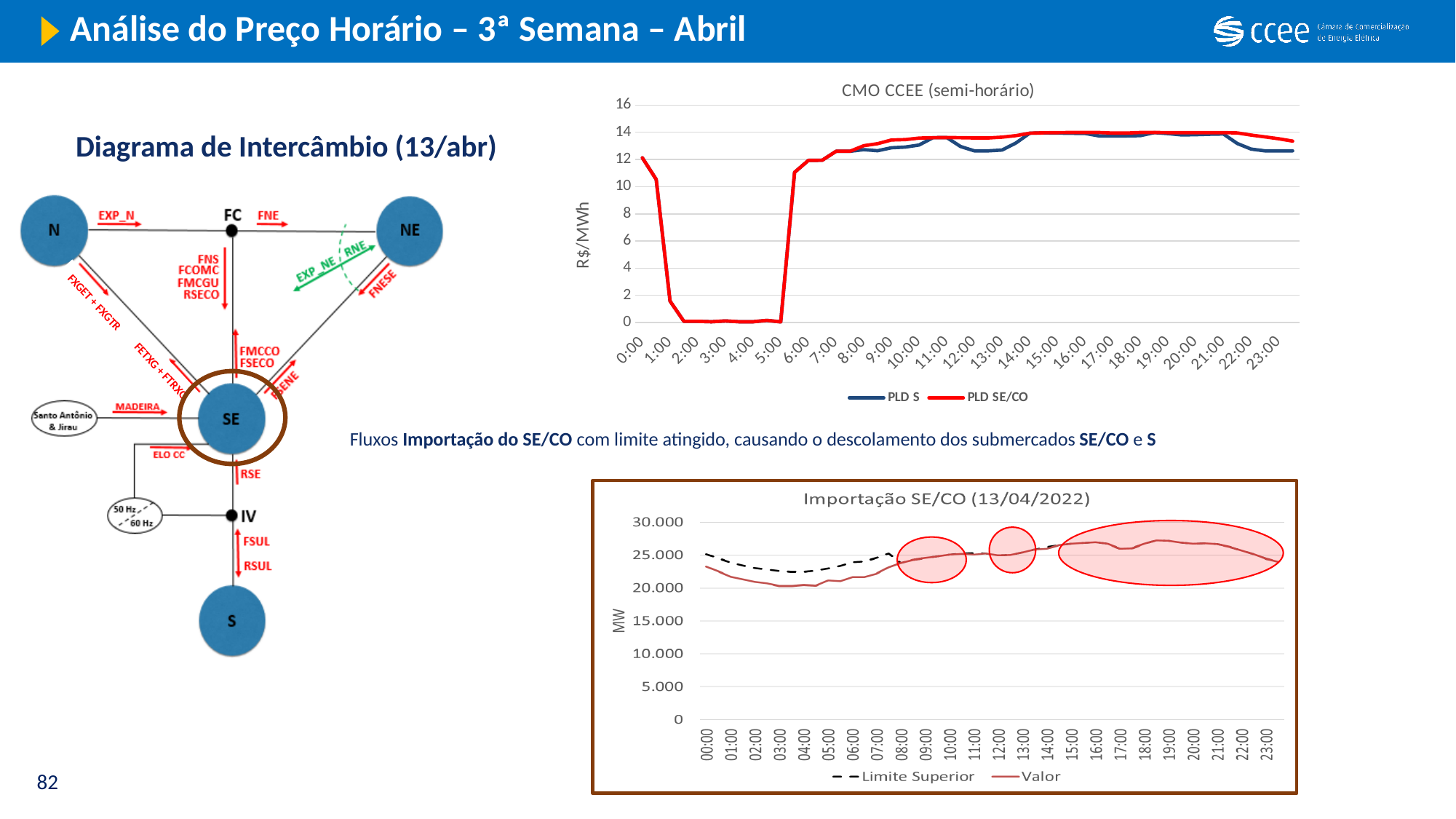
In the 'Importação SE/CO (13/04/2022)' chart, is the value of Valor at 19:00 greater or less than 25.000? greater How many series does the legend of the 'CMO CCEE (semi-horário)' chart list? 2 What kind of chart is the 'CMO CCEE (semi-horário)' chart? line chart What kind of chart is the 'Importação SE/CO (13/04/2022)' chart? line chart In the 'Importação SE/CO (13/04/2022)' chart, do the values of Valor rise or fall between 05:00 and 08:00? rise In the 'CMO CCEE (semi-horário)' chart, do the values of PLD SE/CO rise or fall between 0:00 and 2:00? fall In the 'CMO CCEE (semi-horário)' chart, is the value of PLD SE/CO at 3:00 greater or less than 2? less What is the y-axis label of the 'CMO CCEE (semi-horário)' chart? R$/MWh In the 'CMO CCEE (semi-horário)' chart, is the value of PLD SE/CO at 15:00 greater or less than 12? greater In the 'Importação SE/CO (13/04/2022)' chart, which series has the larger value at 03:00, Limite Superior or Valor? Limite Superior In the 'CMO CCEE (semi-horário)' chart, which series has the larger value at 13:00, PLD S or PLD SE/CO? PLD SE/CO How many series does the legend of the 'Importação SE/CO (13/04/2022)' chart list? 2